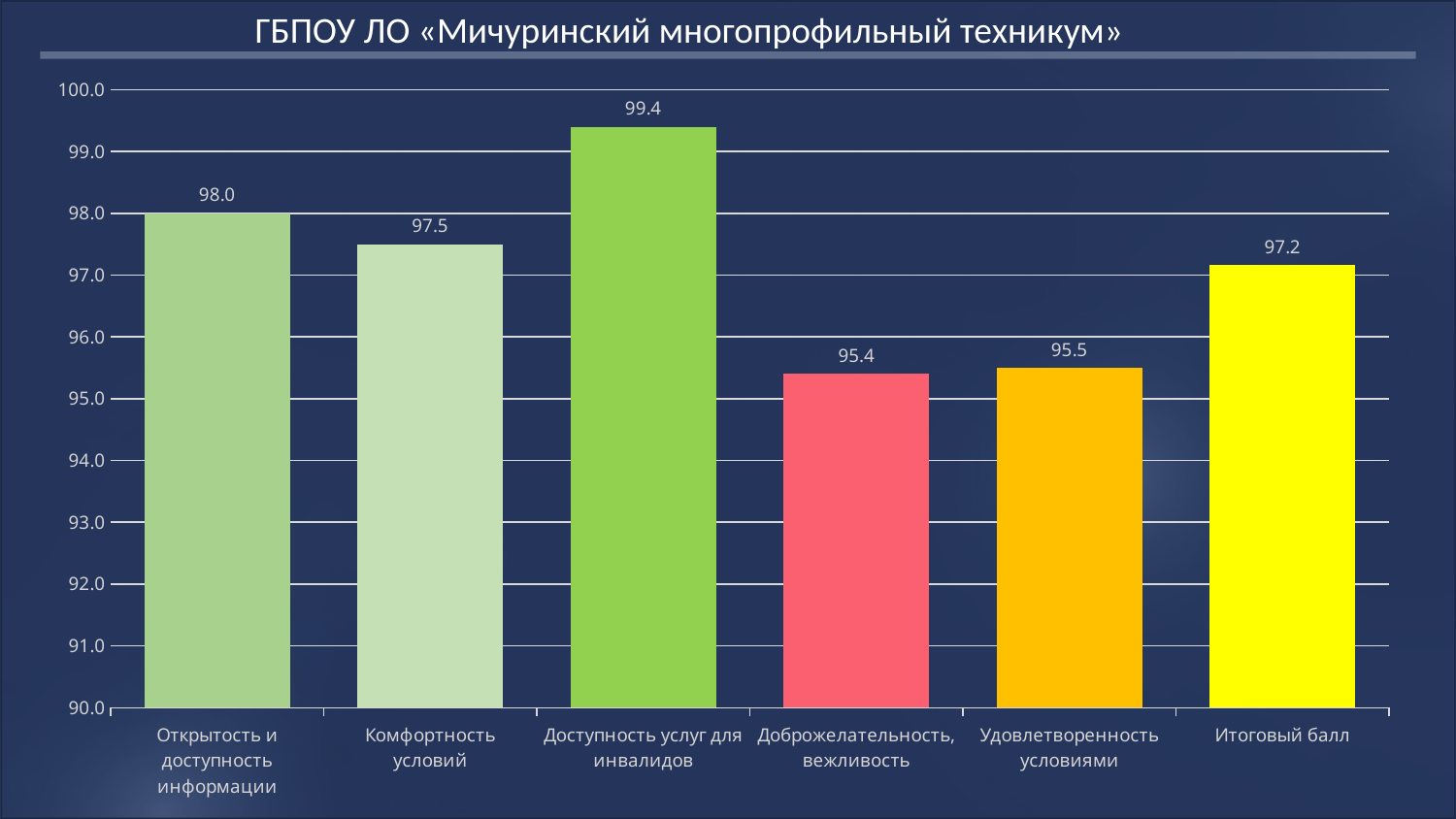
What is the difference between the values for «Доступность услуг для инвалидов» and «Доброжелательность, вежливость»? 4.0 Which category has the highest value? Доступность услуг для инвалидов What is the title of the chart? ГБПОУ ЛО «Мичуринский многопрофильный техникум» What is the value for «Итоговый балл»? 97.2 How many categories are shown on the chart? 6 What is the difference between the values for «Открытость и доступность информации» and «Комфортность условий»? 0.5 Which category has the lowest value? Доброжелательность, вежливость What kind of chart is shown on the slide? bar chart Which is larger: the value for «Открытость и доступность информации» or for «Итоговый балл»? Открытость и доступность информации Is the value for «Удовлетворенность условиями» greater or less than 96.0? less What is the value for «Комфортность условий»? 97.5 What is the value for «Доступность услуг для инвалидов»? 99.4